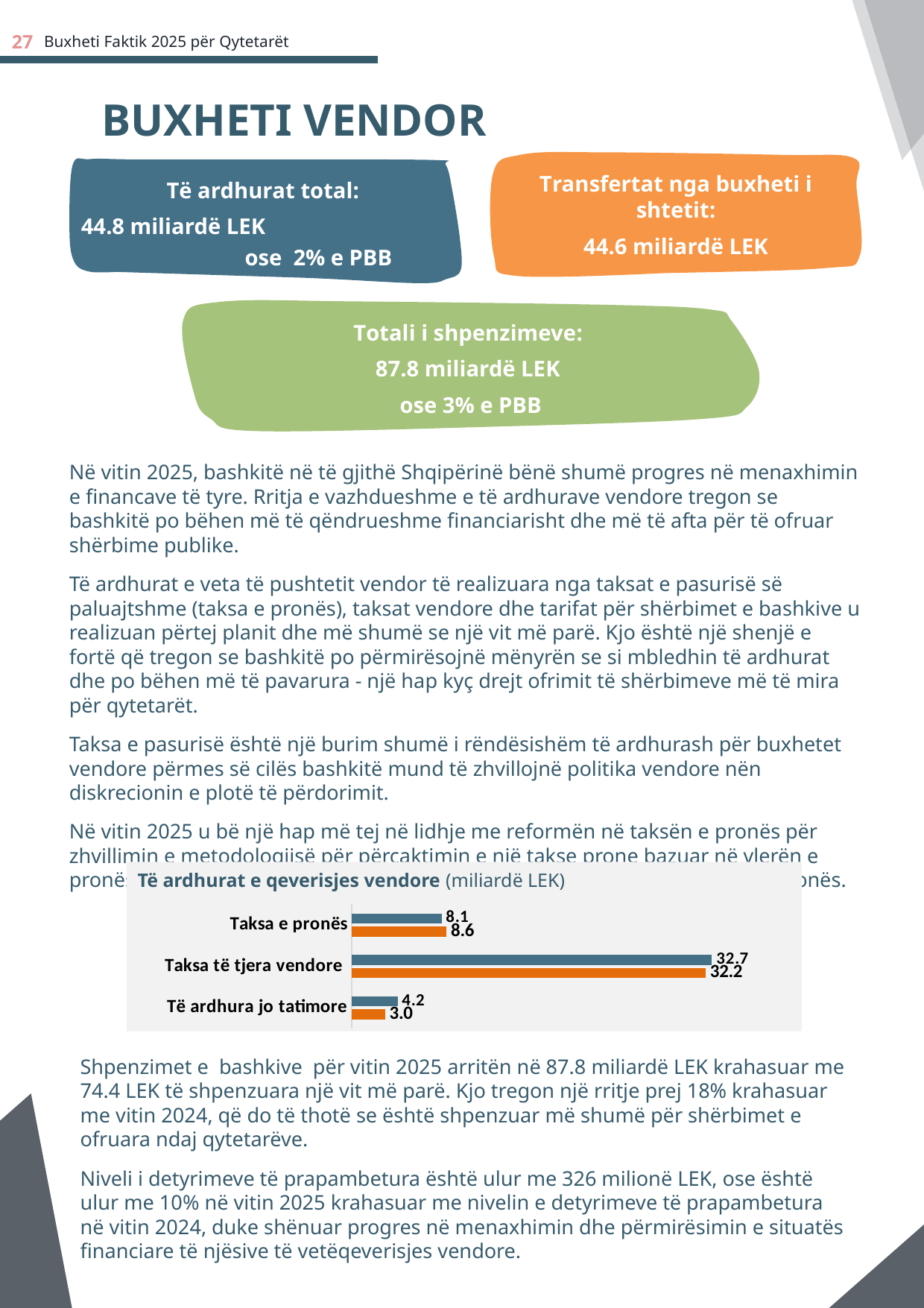
In the 'Të ardhurat e qeverisjes vendore' chart, what is the value of the orange bar for 'Të ardhura jo tatimore'? 3.0 In the 'Të ardhurat e qeverisjes vendore' chart, what is the difference between the blue and orange bar values for 'Të ardhura jo tatimore'? 1.2 In the 'Të ardhurat e qeverisjes vendore' chart, what is the value of the orange bar for 'Taksa e pronës'? 8.6 In the 'Të ardhurat e qeverisjes vendore' chart, which category has the highest blue bar value? Taksa të tjera vendore How many categories are shown in the 'Të ardhurat e qeverisjes vendore' chart? 3 In the 'Të ardhurat e qeverisjes vendore' chart, which is larger for 'Taksa të tjera vendore': the blue bar or the orange bar? the blue bar In the 'Të ardhurat e qeverisjes vendore' chart, what is the value of the blue bar for 'Taksa e pronës'? 8.1 In the 'Të ardhurat e qeverisjes vendore' chart, which category has the lowest orange bar value? Të ardhura jo tatimore What type of chart is shown under the title 'Të ardhurat e qeverisjes vendore'? bar chart In the 'Të ardhurat e qeverisjes vendore' chart, what is the value of the blue bar for 'Taksa të tjera vendore'? 32.7 In the 'Të ardhurat e qeverisjes vendore' chart, what is the difference between the orange and blue bar values for 'Taksa e pronës'? 0.5 What unit is stated in the title of the 'Të ardhurat e qeverisjes vendore' chart? miliardë LEK